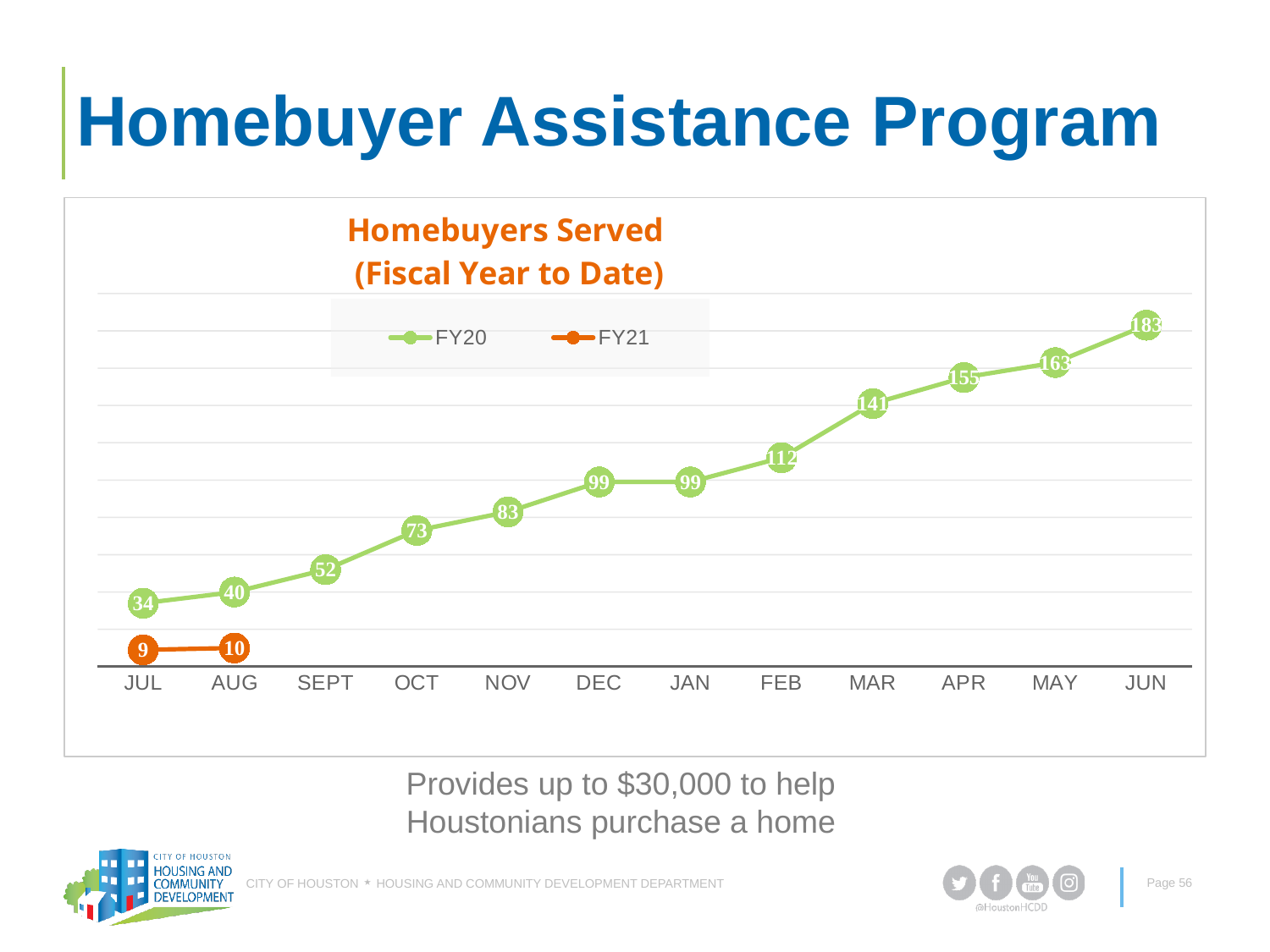
Which is larger, the FY20 value for FEB or the FY20 value for DEC? FEB How many months are shown on the x axis? 12 What is the difference between the FY20 values for JUN and MAY? 20 What kind of chart is this? line chart Do the FY20 values rise or fall from JUL to JUN? rise What is the FY21 value for AUG? 10 Which month has the highest FY20 value? JUN What is the FY20 value for MAR? 141 How many series does the legend list? 2 What is the FY20 value for OCT? 73 Which month has the lowest FY20 value? JUL What is the difference between the FY20 and FY21 values for JUL? 25